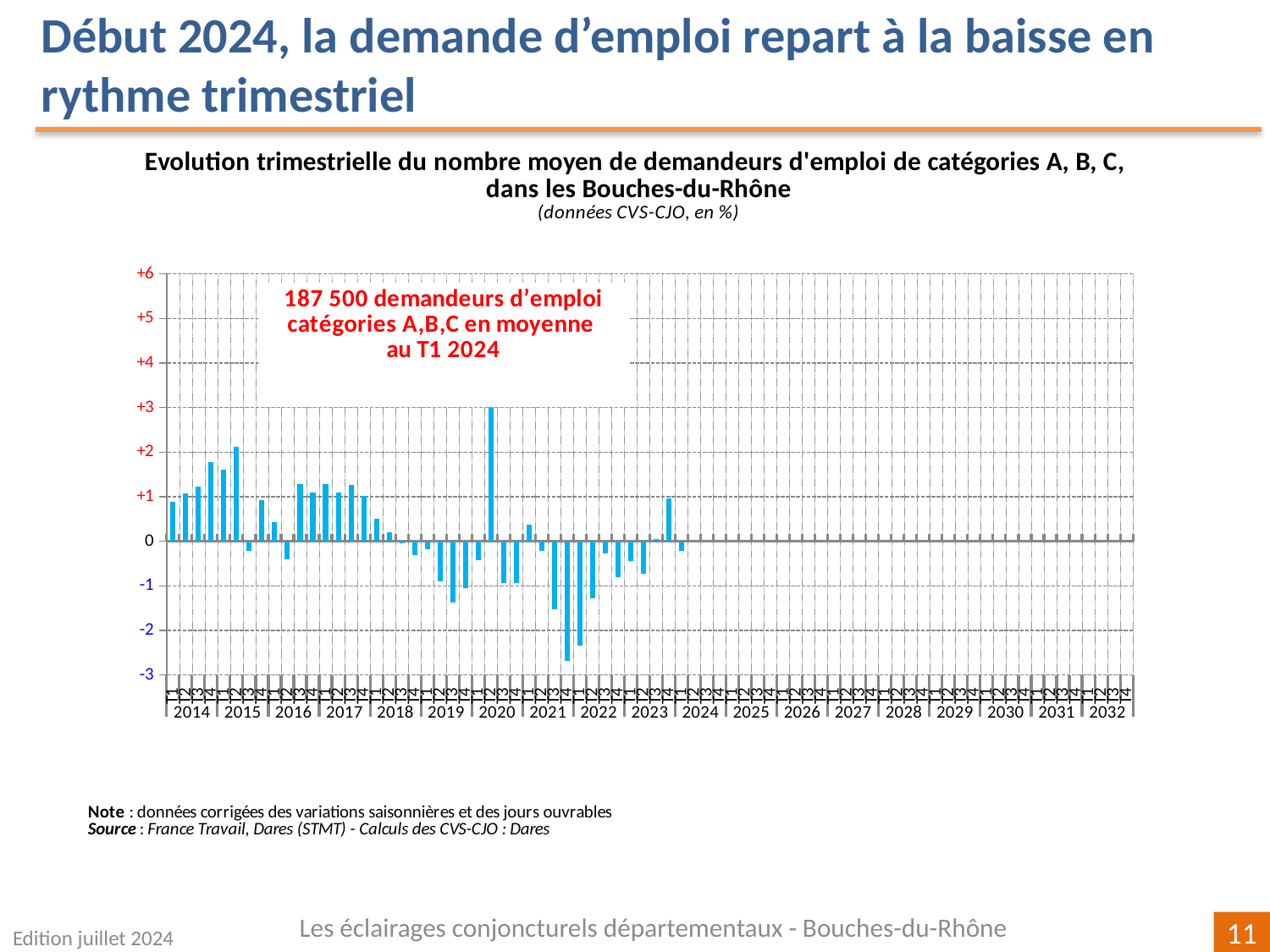
According to the annotation on the chart, how many job seekers in categories A, B, C were there on average in T1 2024? 187 500 Which is larger: the tallest bar in 2020 or the tallest bar in 2015? The tallest bar in 2020 Is the value of the last bar of 2014 (T4) greater or less than +1? greater Is the value of the third bar of 2019 (T3) greater or less than -1? less Is the value of the first bar of 2024 (T1) greater or less than 0? less What kind of chart is shown on the slide? Bar chart What unit are the chart's values expressed in, according to the subtitle? % In which year does the lowest bar (the largest quarterly decrease) occur? 2021 How many years are labelled along the x axis, from 2014 to 2032? 19 In which year does the tallest positive bar (the largest quarterly increase) occur? 2020